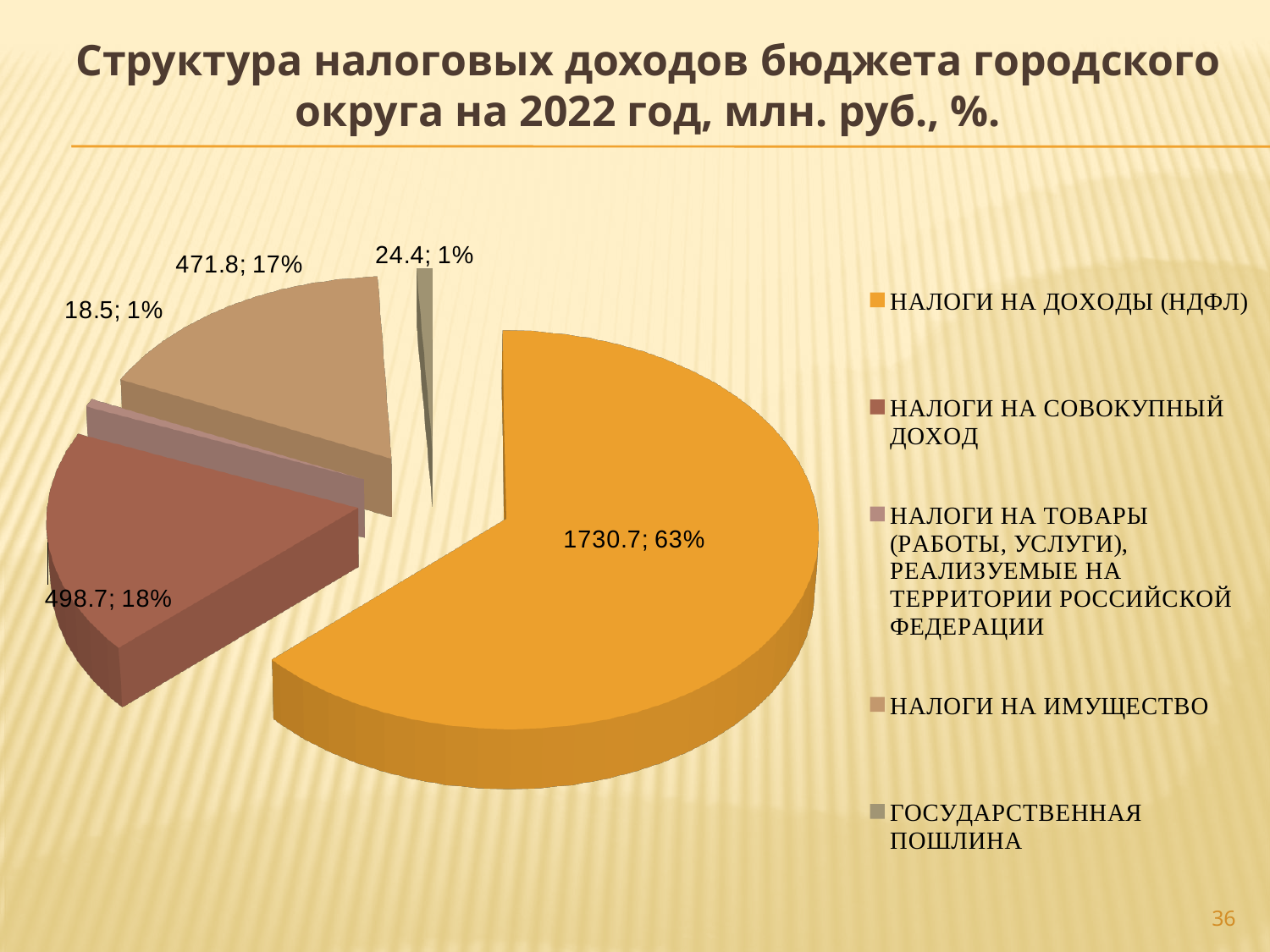
Which is larger: the value for НАЛОГИ НА СОВОКУПНЫЙ ДОХОД or the value for НАЛОГИ НА ИМУЩЕСТВО? НАЛОГИ НА СОВОКУПНЫЙ ДОХОД What colour is the slice for НАЛОГИ НА ДОХОДЫ (НДФЛ)? orange What share of the pie does НАЛОГИ НА ИМУЩЕСТВО represent? 17% What value is shown for НАЛОГИ НА СОВОКУПНЫЙ ДОХОД? 498.7 What value is shown for НАЛОГИ НА ДОХОДЫ (НДФЛ)? 1730.7 What share of the pie does НАЛОГИ НА ДОХОДЫ (НДФЛ) represent? 63% Which category has the smallest value in the pie chart? НАЛОГИ НА ТОВАРЫ (РАБОТЫ, УСЛУГИ), РЕАЛИЗУЕМЫЕ НА ТЕРРИТОРИИ РОССИЙСКОЙ ФЕДЕРАЦИИ How many slices does the pie chart have? 5 Which category has the largest slice of the pie? НАЛОГИ НА ДОХОДЫ (НДФЛ) What value is shown for ГОСУДАРСТВЕННАЯ ПОШЛИНА? 24.4 What is the difference between the values for НАЛОГИ НА СОВОКУПНЫЙ ДОХОД and НАЛОГИ НА ИМУЩЕСТВО? 26.9 What kind of chart is shown on the slide? pie chart